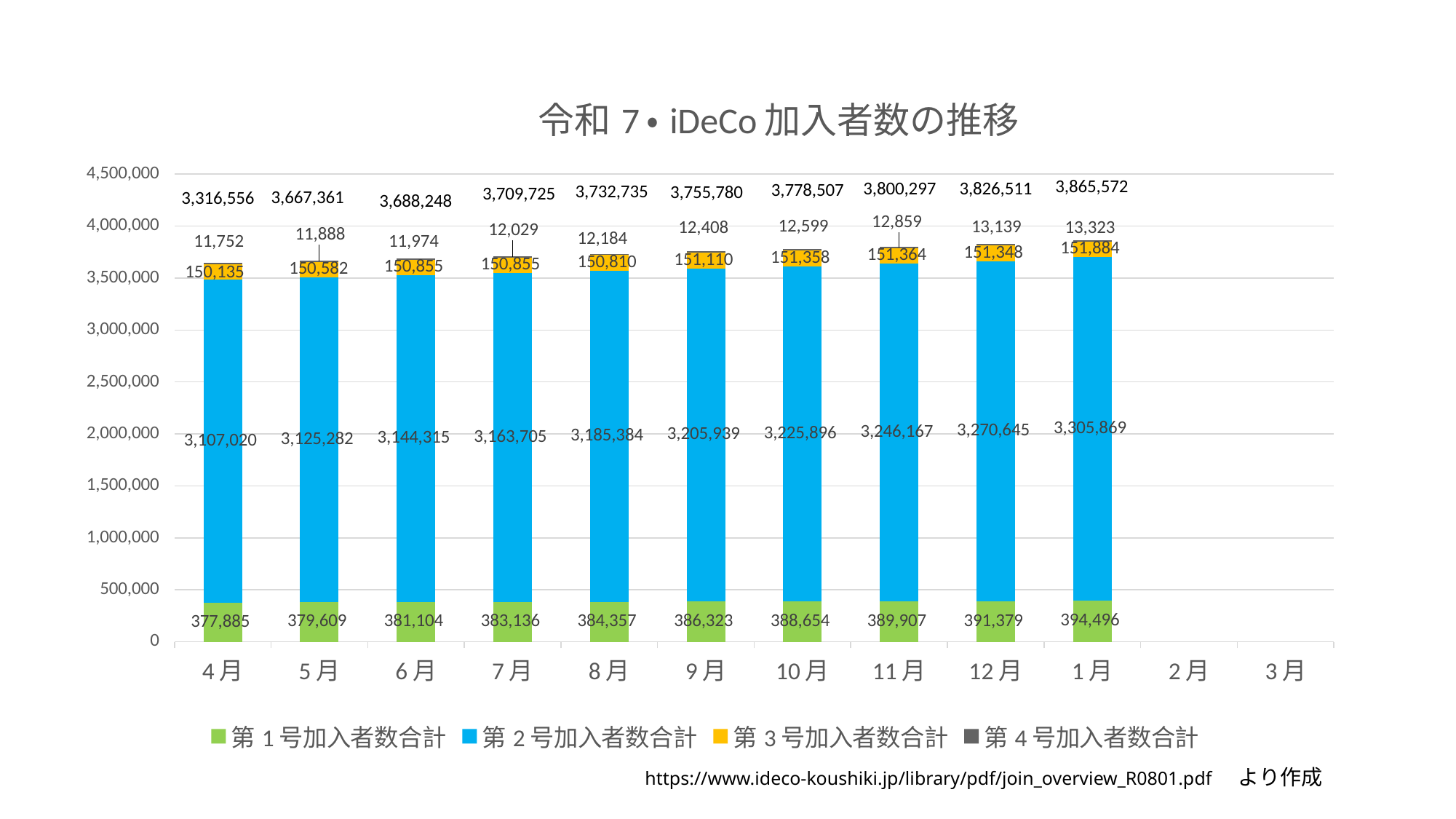
What is the value of 第1号加入者数合計 for 1月? 394,496 Which month has the highest value for 第2号加入者数合計? 1月 How many months have bars plotted in the chart? 10 What is the title of the chart? 令和7・iDeCo加入者数の推移 Does the value of 第2号加入者数合計 rise or fall from 4月 to 1月? Rise What is the value of 第4号加入者数合計 for 9月? 12,408 What type of chart is shown on the slide? Stacked bar chart What is the value of 第3号加入者数合計 for 11月? 151,364 What is the difference between the 第2号加入者数合計 values for 1月 and 4月? 198,849 How many series does the legend list? 4 What is the total of the stacked bar for 1月? 3,865,572 What is the value of 第2号加入者数合計 for 4月? 3,107,020